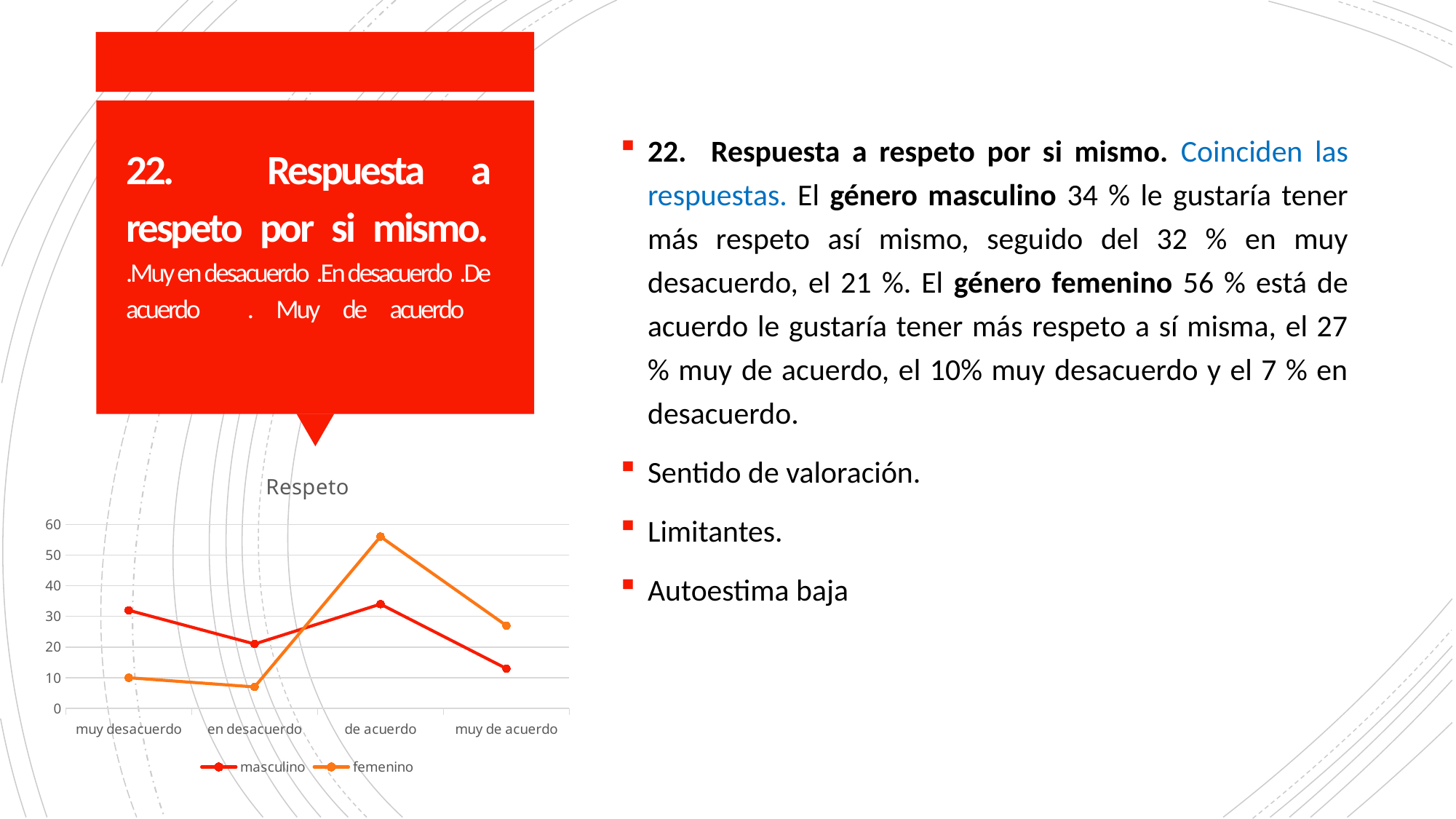
Is the value for femenino at 'en desacuerdo' greater or less than 10? less For which category does the femenino series reach its highest value? de acuerdo At 'de acuerdo', which series has the larger value, masculino or femenino? femenino For which category does the masculino series have its lowest value? muy de acuerdo At 'muy desacuerdo', which series has the larger value, masculino or femenino? masculino What kind of chart is shown on the slide? line chart Is the value for femenino at 'de acuerdo' greater or less than 50? greater How many series does the chart legend list? 2 For which category does the femenino series have its lowest value? en desacuerdo How many categories are shown on the x axis of the chart? 4 Does the femenino series rise or fall from 'en desacuerdo' to 'de acuerdo'? rise What is the title of the chart? Respeto